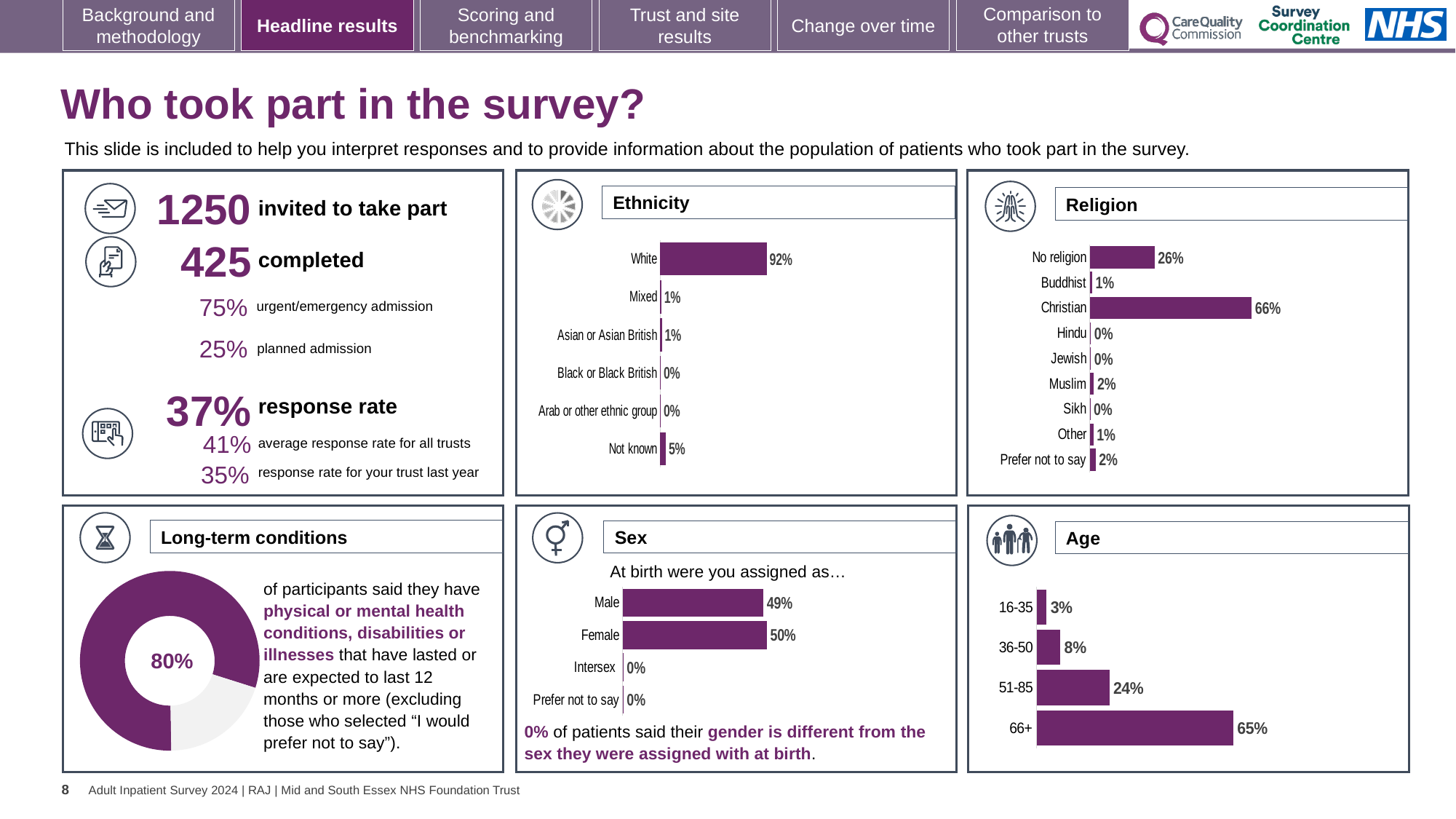
What kind of chart is used in the Long-term conditions panel? Donut (pie) chart In the Religion chart, which is larger, Muslim or Prefer not to say? They are equal (2%) How many categories does the Religion chart show? 9 In the Age chart, what is the difference between the 66+ and 51-85 values? 41% In the Religion chart, what is the difference between the Christian and No religion values? 40% In the Sex chart, what percentage of respondents were Female? 50% In the Age chart, do the values rise or fall as the age groups get older? Rise In the Ethnicity chart, what percentage of respondents were White? 92% In the Age chart, which age group has the highest value? 66+ In the Religion chart, what percentage of respondents were Christian? 66% In the Ethnicity chart, which category has the highest value? White How many categories does the Ethnicity chart show? 6